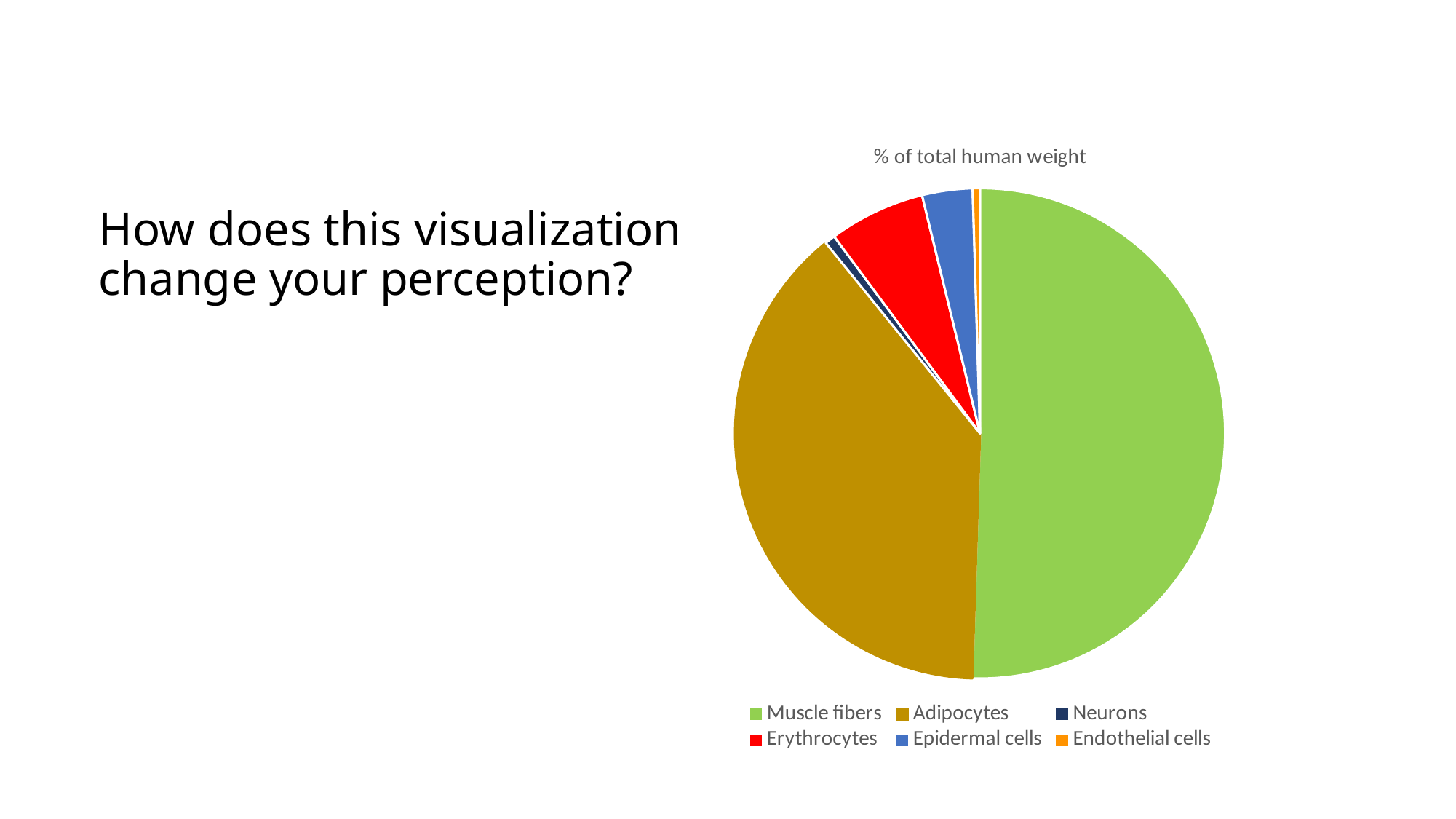
What is the title of the pie chart? % of total human weight How many categories does the pie chart's legend list? 6 Which is larger, the slice for Muscle fibers or the slice for Adipocytes? Muscle fibers Which is larger, the slice for Adipocytes or the slice for Erythrocytes? Adipocytes Which category has the largest slice of the pie? Muscle fibers What colour is the slice for Erythrocytes? red What kind of chart is shown on the slide? pie chart Which is larger, the slice for Erythrocytes or the slice for Neurons? Erythrocytes Which category has the second-largest slice of the pie? Adipocytes